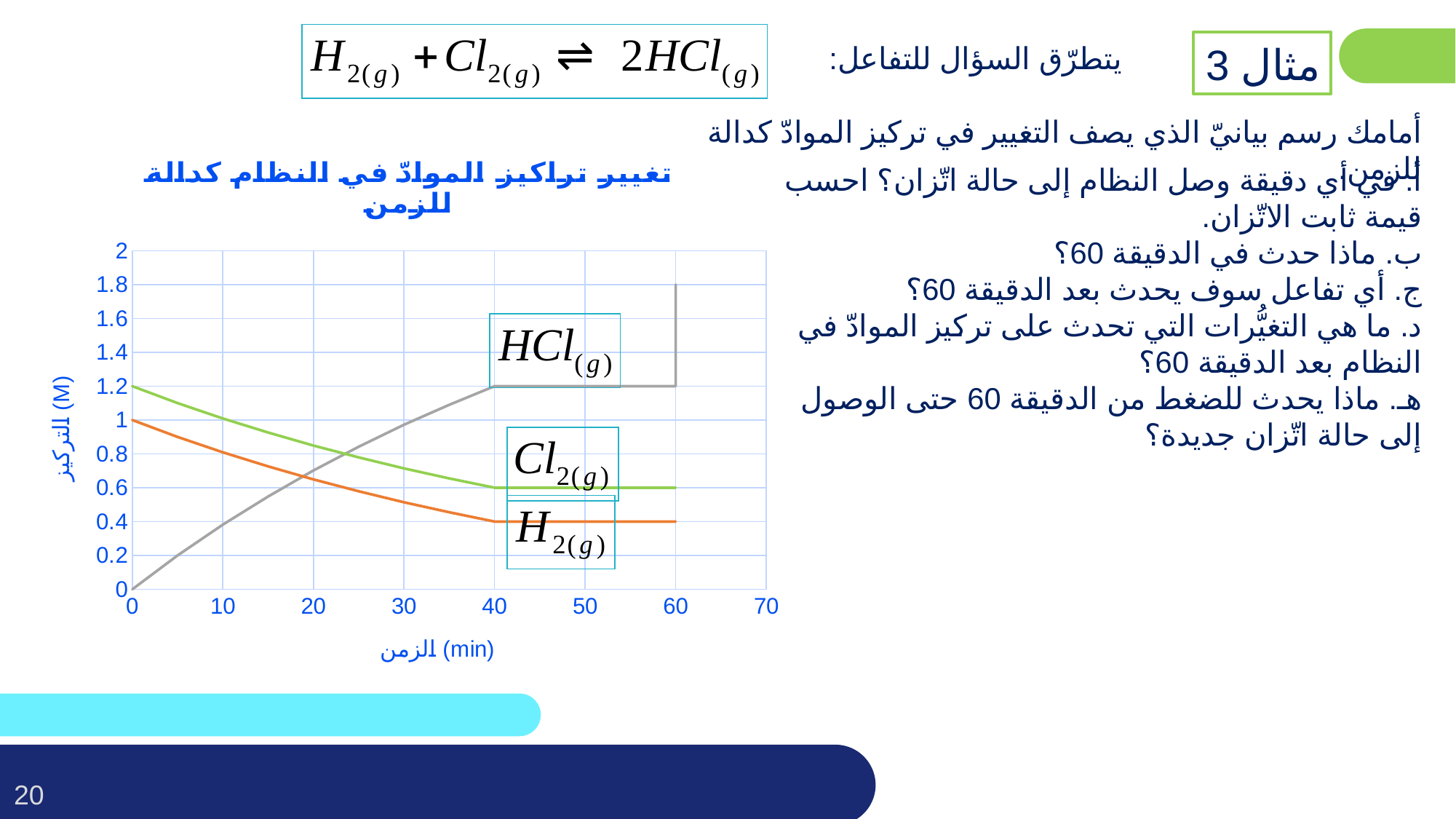
What is the concentration of HCl(g) at 50 min? 1.2 What is the concentration of Cl2(g) at time 0 min? 1.2 To what value does the HCl(g) concentration jump at 60 min? 1.8 Which substance has the highest concentration at 50 min? HCl(g) What is the concentration of Cl2(g) at 50 min? 0.6 What is the concentration of H2(g) at time 0 min? 1 How many substances (series) are plotted on the chart? 3 What is the concentration of H2(g) at 50 min? 0.4 What is the difference between the concentrations of Cl2(g) and H2(g) at 50 min? 0.2 Does the concentration of HCl(g) rise or fall between 0 and 40 min? rise What is the concentration of HCl(g) at time 0 min? 0 What kind of chart is shown on the slide? line chart